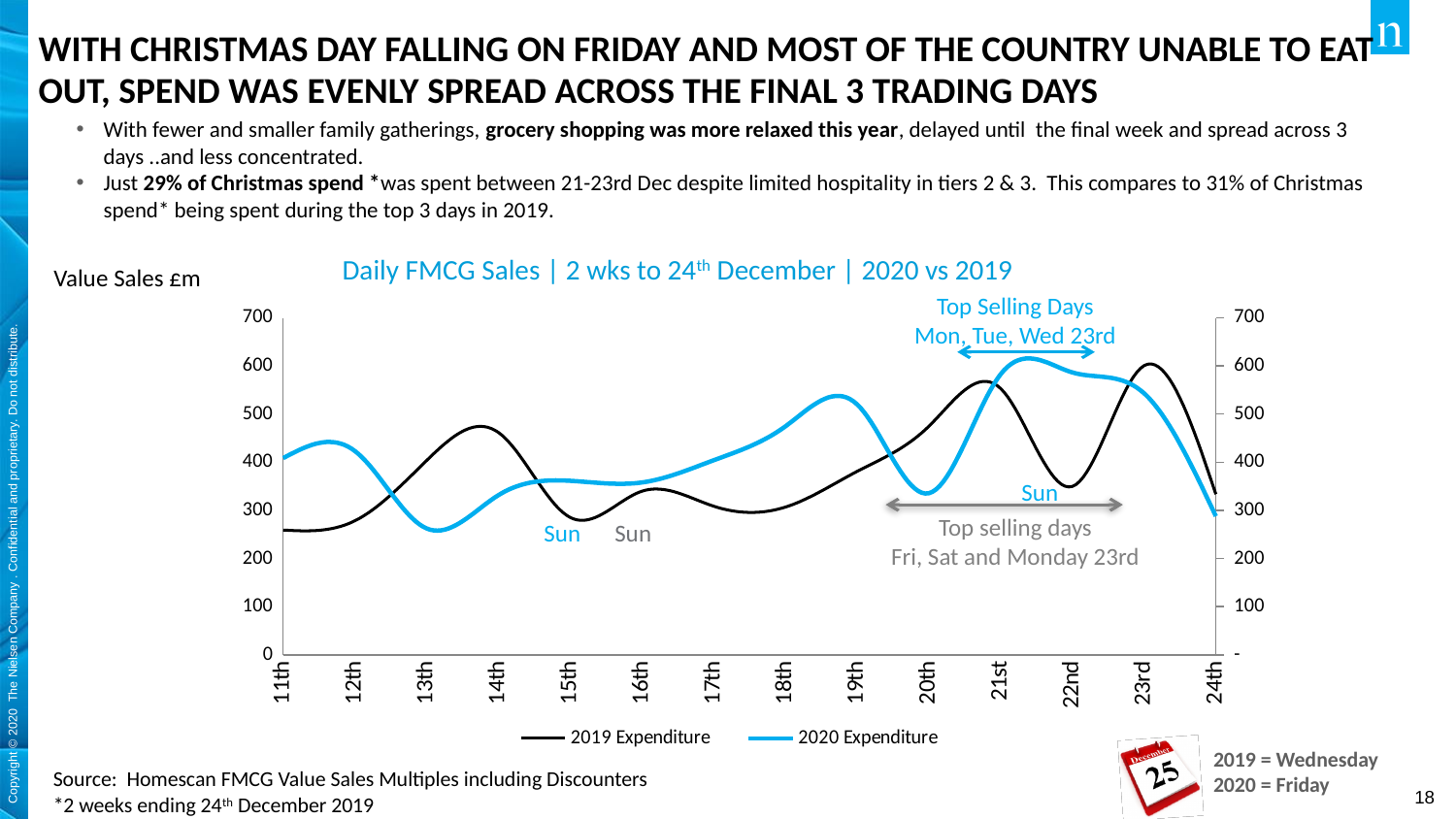
Is the 2019 Expenditure value on the 22nd greater or less than 400? less Is the 2020 Expenditure value on the 19th greater or less than 500? greater On the 22nd, which series has the higher value, 2019 Expenditure or 2020 Expenditure? 2020 Expenditure What is the title of the chart? Daily FMCG Sales | 2 wks to 24th December | 2020 vs 2019 Is the 2019 Expenditure value on the 14th greater or less than 400? greater On the 14th, which series has the higher value, 2019 Expenditure or 2020 Expenditure? 2019 Expenditure How many dates are plotted along the x axis of the chart? 14 How many series does the chart legend list? 2 What kind of chart is shown on the slide? line chart Which series is drawn in blue on the chart? 2020 Expenditure